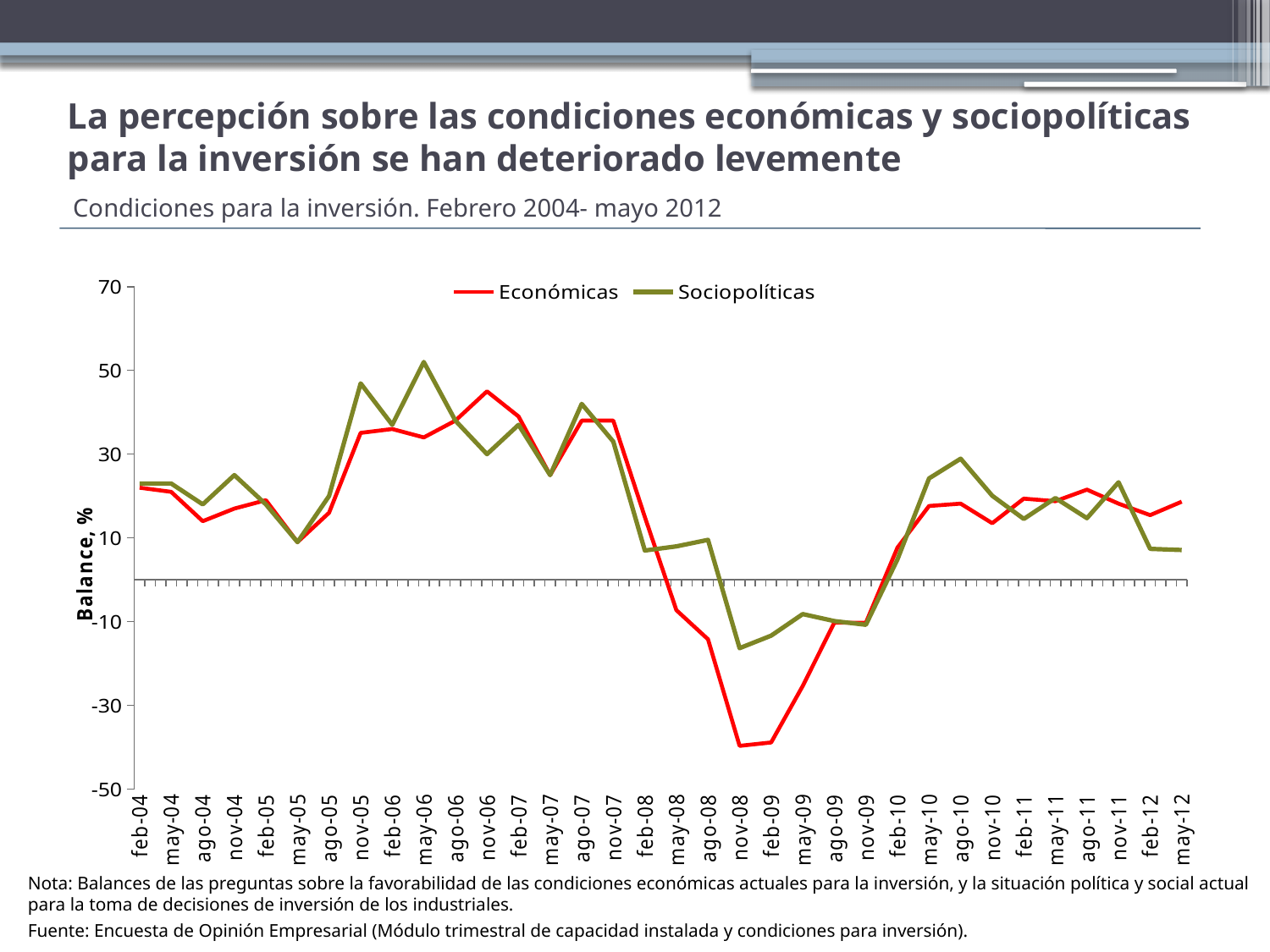
What is the label of the vertical axis? Balance, % Is the value of Sociopolíticas at may-12 greater or less than 10? less Is the value of Económicas at nov-06 greater or less than 30? greater Does the Económicas series rise or fall between feb-08 and nov-08? fall At which date does the Sociopolíticas series reach its highest value? may-06 At nov-08, which series has the higher value, Económicas or Sociopolíticas? Sociopolíticas What kind of chart is shown on the slide? line chart What are the two series named in the legend? Económicas and Sociopolíticas How many series does the legend list? 2 Is the value of Económicas at nov-08 greater or less than -30? less At may-06, which series has the higher value, Económicas or Sociopolíticas? Sociopolíticas